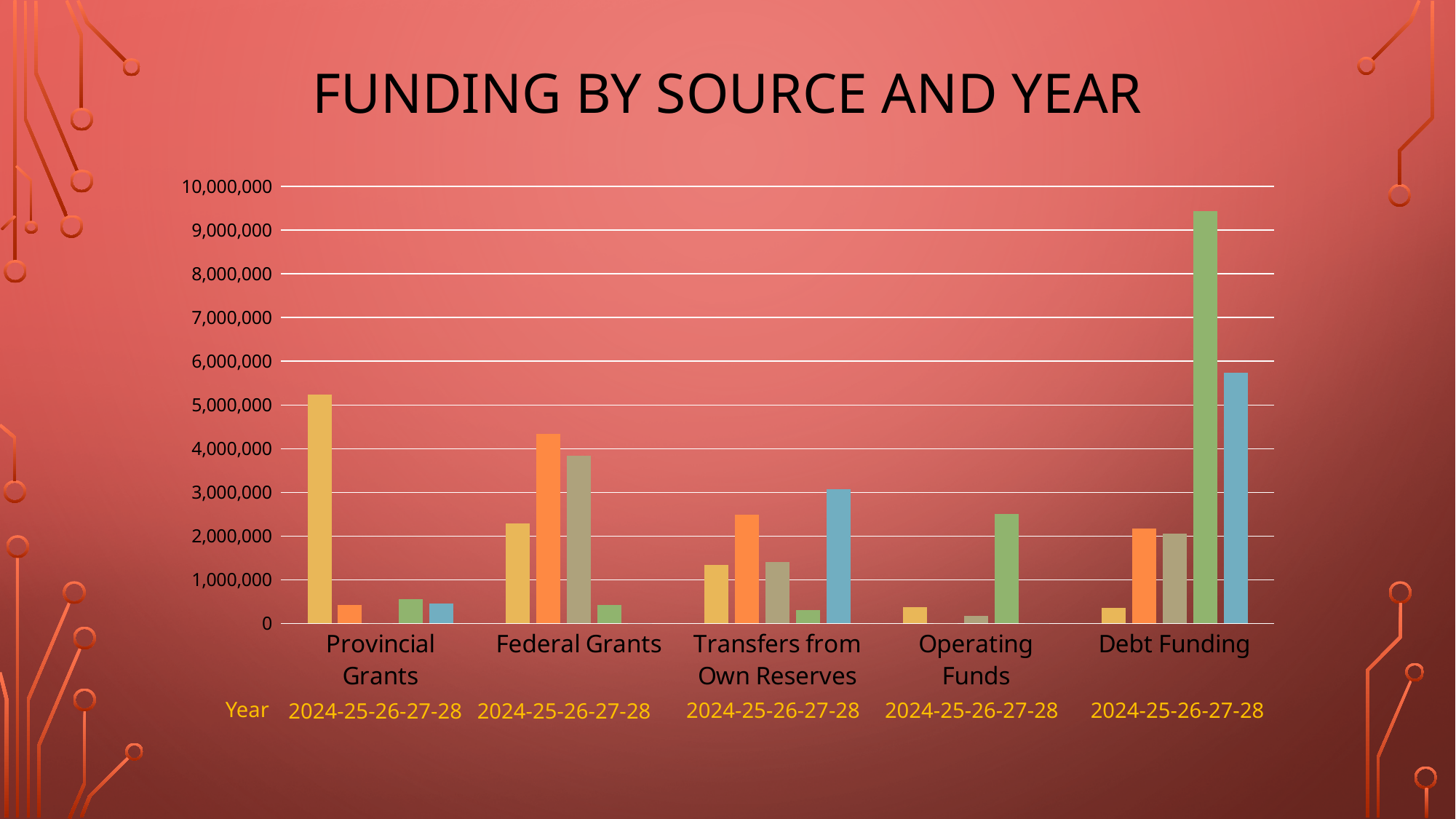
How many funding source categories are shown on the x axis? 5 Which is larger for Federal Grants: the 2024 bar or the 2025 bar? 2025 Is the tallest bar for Debt Funding greater or less than 9,000,000? greater What kind of chart is shown on the slide? bar chart Which funding source has the tallest bar in the chart? Debt Funding Which years are listed under each funding source category? 2024-25-26-27-28 Is the 2024 bar for Operating Funds greater or less than 1,000,000? less Which is larger for Debt Funding: the 2027 bar or the 2028 bar? 2027 Is the 2025 bar for Federal Grants greater or less than 4,000,000? greater What is the title of the chart? Funding by Source and Year